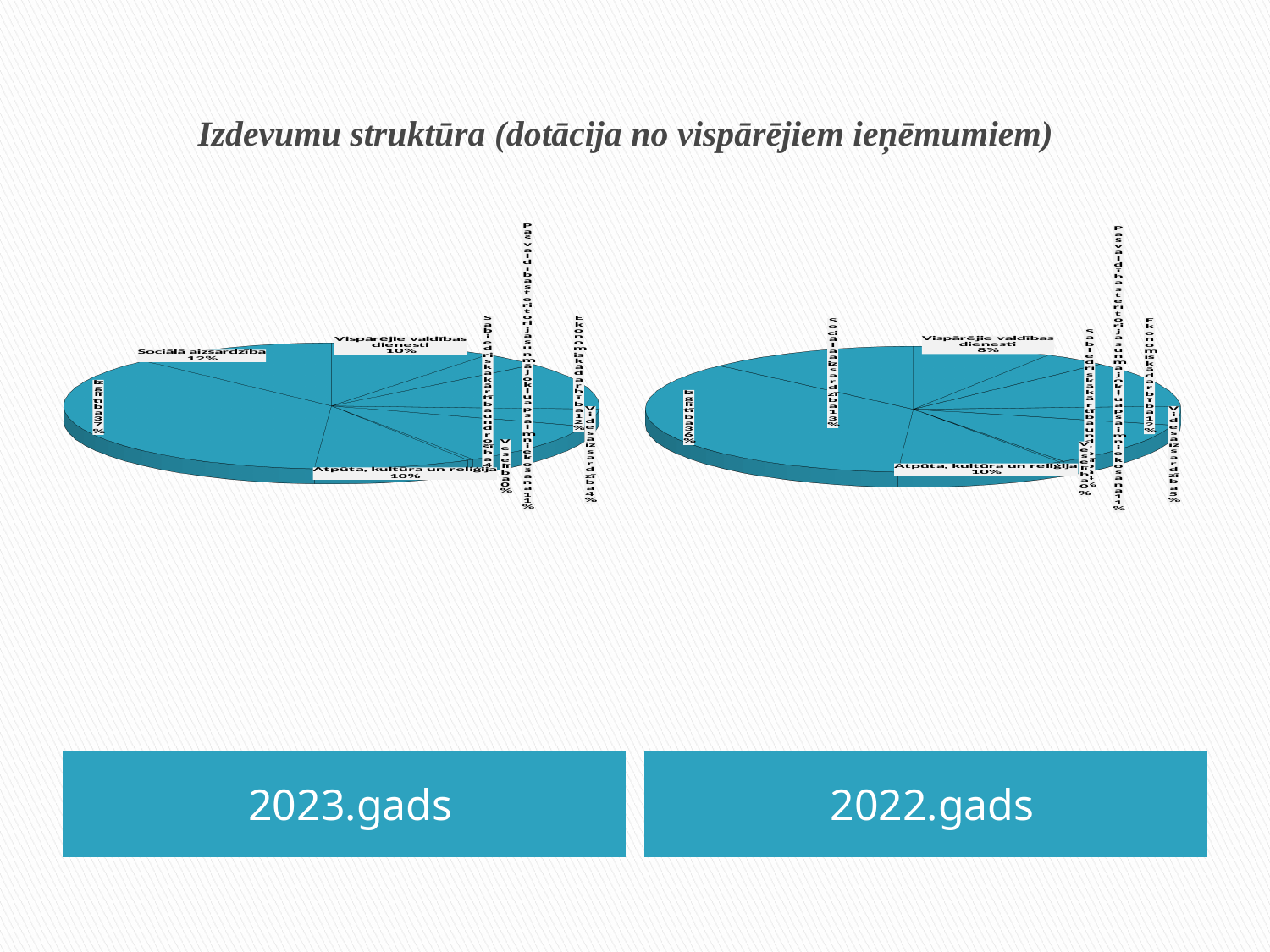
In the 2022.gads chart, what share is labelled for Atpūta, kultūra un reliģija? 10% By how many percentage points does the Sociālā aizsardzība share in the 2022.gads chart exceed that in the 2023.gads chart? 1 In the 2022.gads chart, which category has the largest slice? Izglītība In the 2023.gads chart, what share is labelled for Vispārējie valdības dienesti? 10% In the 2023.gads chart, what share is labelled for Sociālā aizsardzība? 12% In the 2022.gads chart, what share is labelled for Sociālā aizsardzība? 13% What kind of chart is shown for 2023.gads? pie chart What is the title shown above the two charts? Izdevumu struktūra (dotācija no vispārējiem ieņēmumiem) Is the share for Vispārējie valdības dienesti larger in the 2023.gads chart or the 2022.gads chart? 2023.gads In the 2023.gads chart, what share is labelled for Atpūta, kultūra un reliģija? 10% In the 2022.gads chart, what share is labelled for Vispārējie valdības dienesti? 8% In the 2023.gads chart, which category has the largest slice? Izglītība